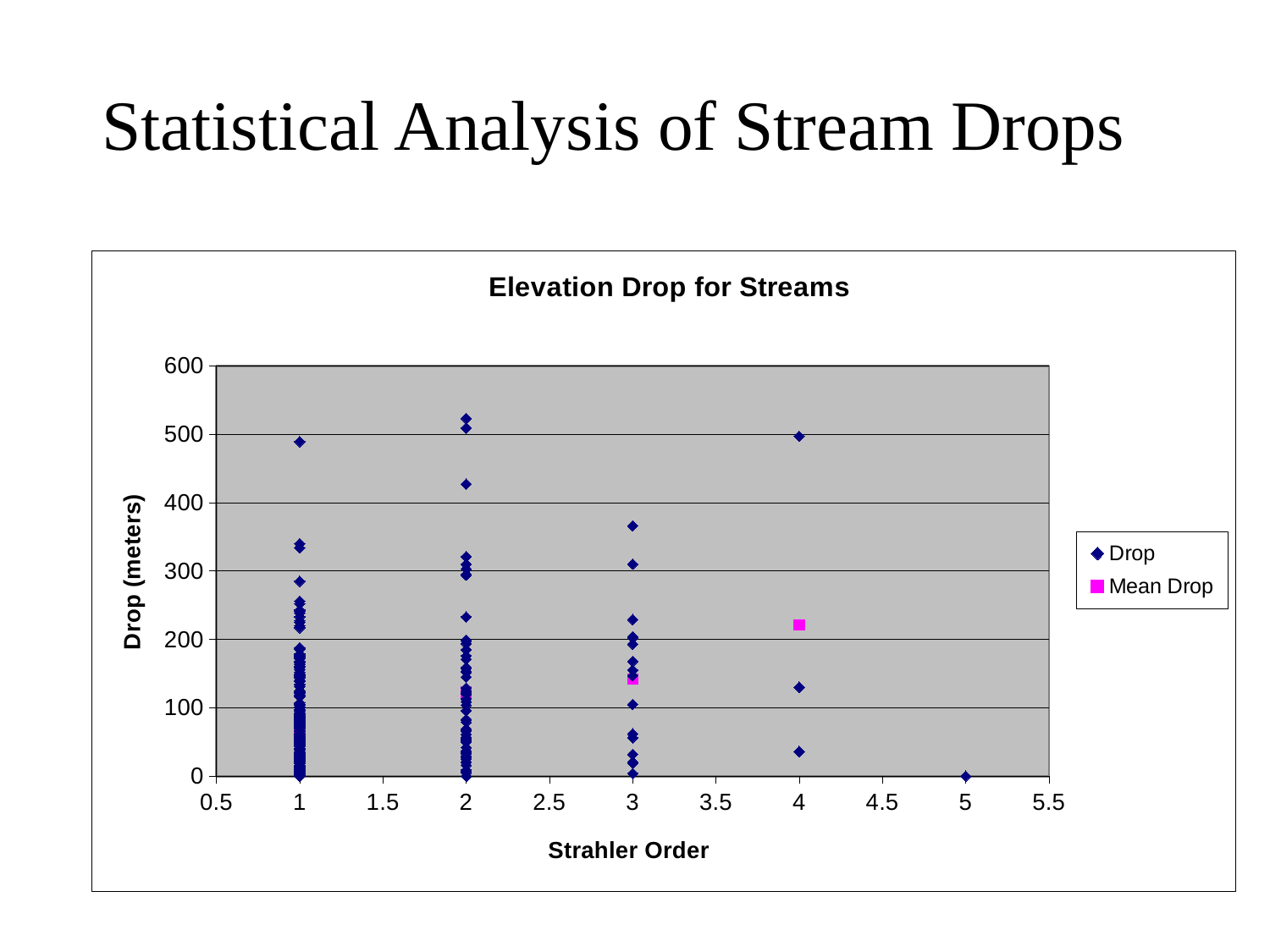
What is the title of the chart? Elevation Drop for Streams How many series does the chart legend list? 2 What kind of chart is shown on the slide? Scatter chart Is the highest Drop value at Strahler Order 3 greater or less than 400? less How many distinct Strahler Order values have Drop points plotted? 5 Is the Mean Drop value at Strahler Order 3 greater or less than 200? less Which has the larger Mean Drop, Strahler Order 3 or Strahler Order 4? Strahler Order 4 Is the Mean Drop value at Strahler Order 4 greater or less than 200? greater What is the label of the vertical axis? Drop (meters) Which Strahler Order has the highest single Drop value plotted? 2